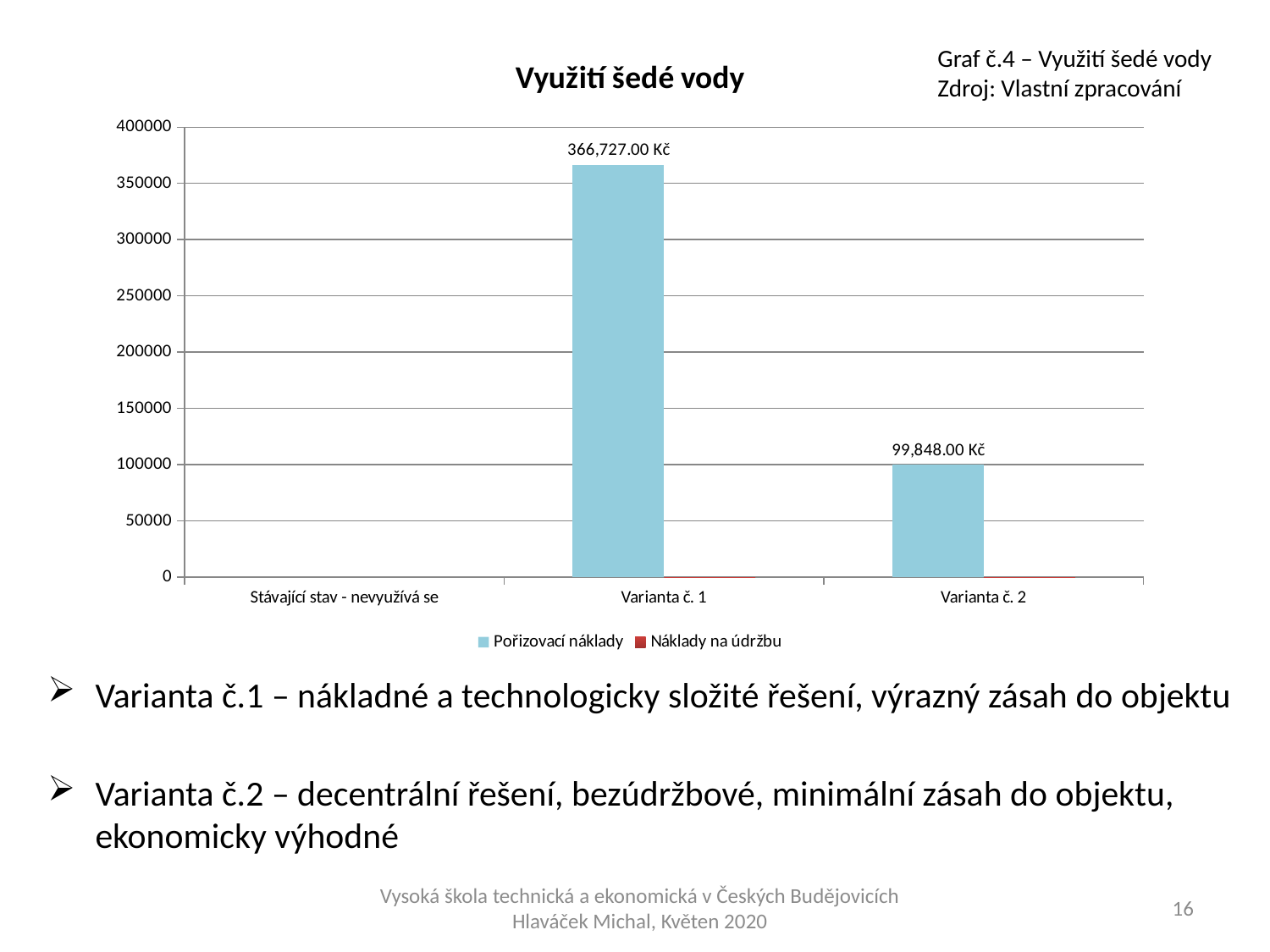
Is the Pořizovací náklady value for Varianta č. 1 greater or less than 350000? greater Which series is shown in blue in the chart legend? Pořizovací náklady What is the value of Pořizovací náklady for Varianta č. 2? 99,848.00 Kč Is the Pořizovací náklady value for Varianta č. 2 greater or less than 150000? less What is the difference between the Pořizovací náklady for Varianta č. 1 and Varianta č. 2? 266,879.00 Kč Which category has the highest Pořizovací náklady? Varianta č. 1 How many categories are shown on the x axis of the chart? 3 How many series does the chart legend list? 2 Which has larger Pořizovací náklady, Varianta č. 1 or Varianta č. 2? Varianta č. 1 What is the title of the chart? Využití šedé vody What is the value of Pořizovací náklady for Varianta č. 1? 366,727.00 Kč What kind of chart is shown on the slide? bar chart